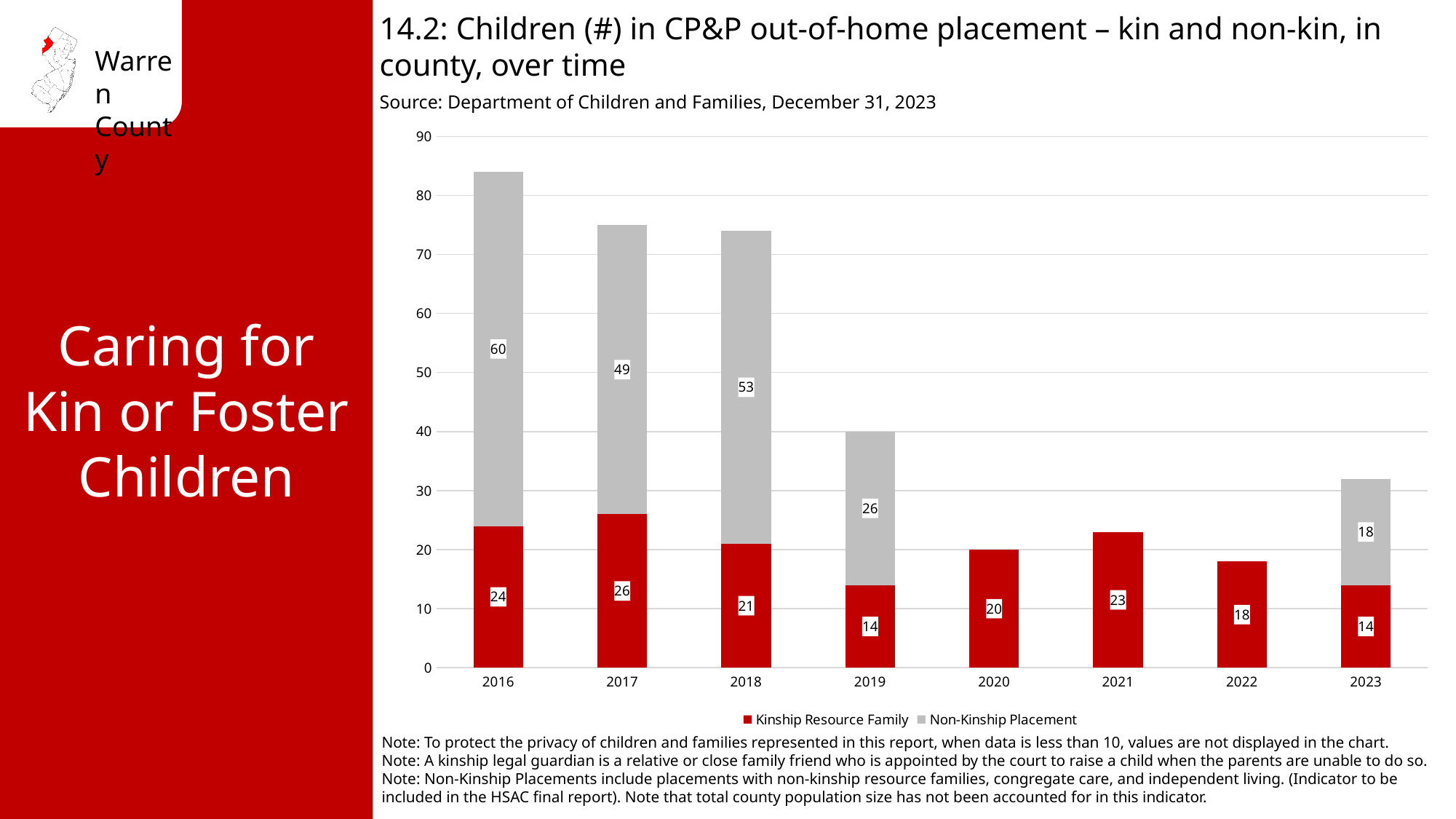
Which year has the highest Kinship Resource Family value? 2017 How many series does the legend list? 2 What is the Non-Kinship Placement value for 2023? 18 What is the Non-Kinship Placement value for 2018? 53 What is the total of the stacked bar for 2016? 84 Which year has the highest Non-Kinship Placement value? 2016 Is the total of the stacked bar for 2019 greater or less than 50? less How many years are shown on the x axis? 8 What is the difference between the Non-Kinship Placement values for 2016 and 2017? 11 What is the Kinship Resource Family value for 2017? 26 Which is larger, the Kinship Resource Family value for 2021 or for 2022? 2021 What kind of chart is shown on the slide? Stacked bar chart